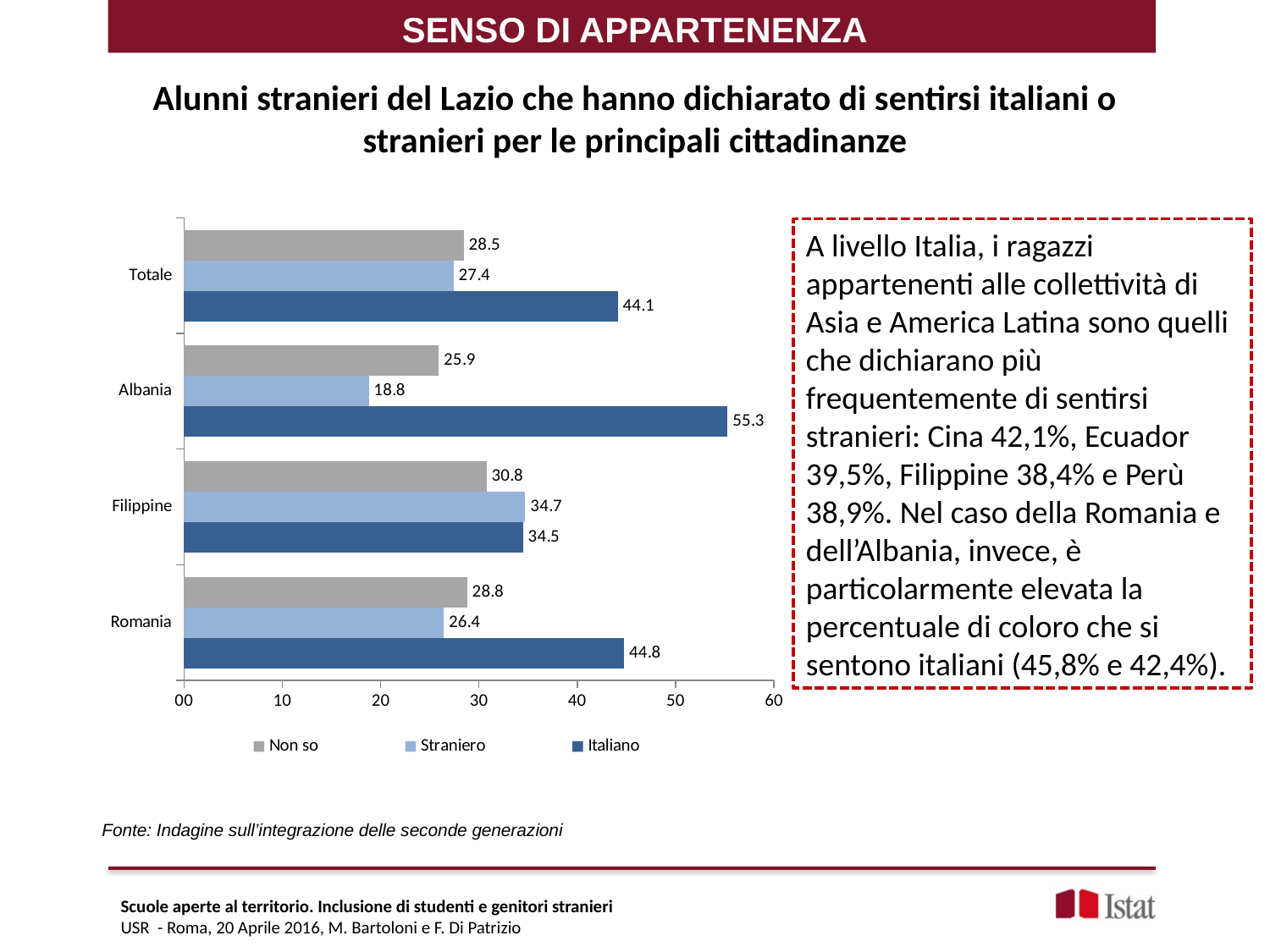
Is the Italiano value for Totale greater or less than 40? greater Which series is shown in dark blue in the legend? Italiano How many categories are shown on the y axis? 4 What is the difference between the Italiano and Straniero values for Albania? 36.5 What is the Non so value for Romania? 28.8 How many series does the legend list? 3 What is the Italiano value for Albania? 55.3 What kind of chart is shown on the slide? bar chart Which category has the lowest Straniero value? Albania Which is larger for Romania, the Italiano value or the Non so value? Italiano Which category has the highest Italiano value? Albania What is the Straniero value for Filippine? 34.7